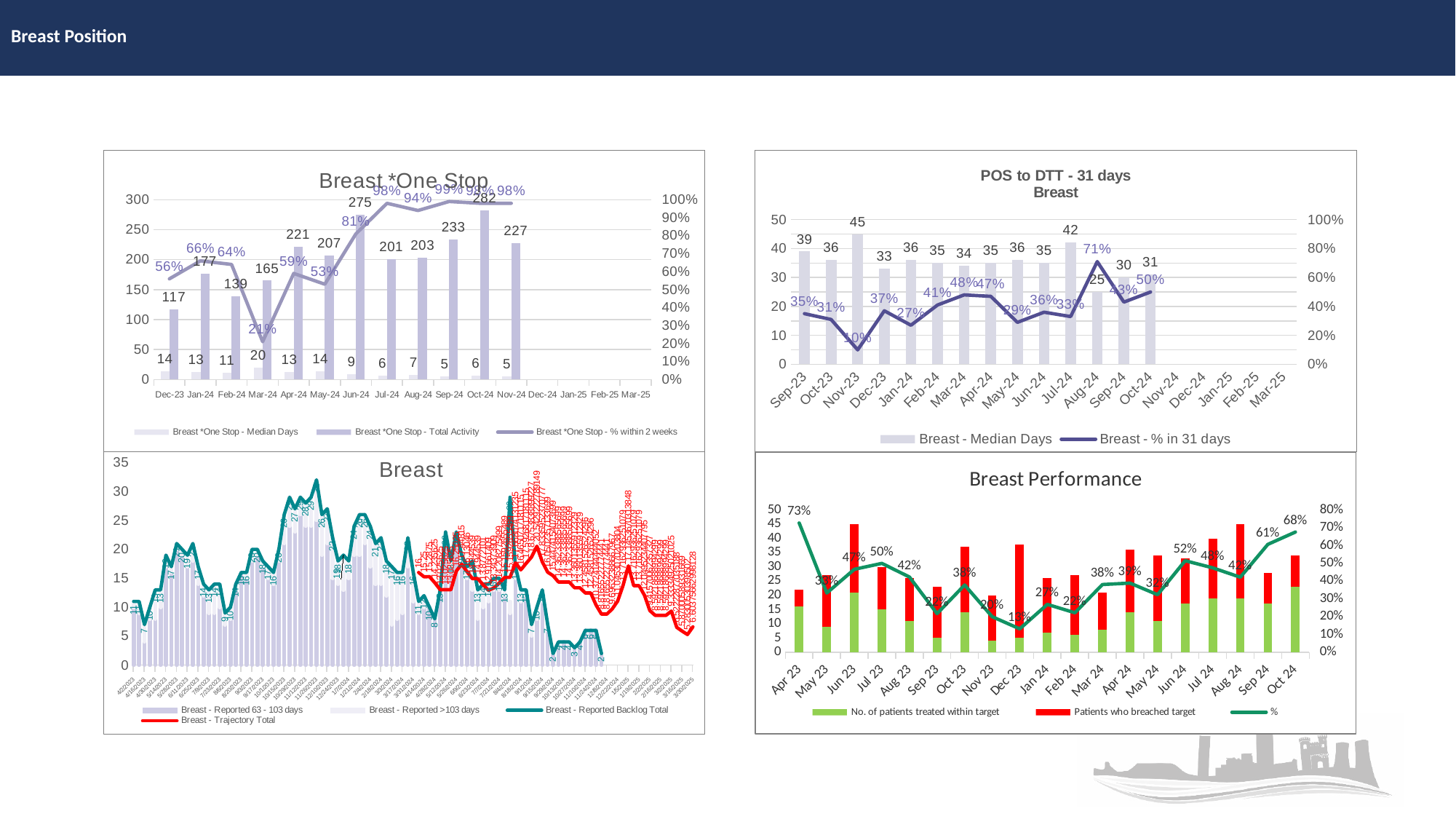
In the 'Breast *One Stop' chart, how many series does the legend list? 3 In the 'Breast *One Stop' chart, which month has the highest Total Activity? Oct-24 In the 'Breast *One Stop' chart, what is the % within 2 weeks for Mar-24? 21% In the 'Breast Performance' chart, what is the % value for Oct 24? 68% In the 'POS to DTT - 31 days Breast' chart, which month has the lowest Median Days? Aug-24 In the 'Breast Performance' chart, which month has the lowest % value? Dec 23 In the 'Breast *One Stop' chart, what is the Total Activity value for Oct-24? 282 In the 'POS to DTT - 31 days Breast' chart, what is the Median Days value for Nov-23? 45 In the 'POS to DTT - 31 days Breast' chart, what is the % in 31 days for Aug-24? 71% In the 'Breast *One Stop' chart, what is the difference in Total Activity between Jun-24 and Jul-24? 74 In the 'POS to DTT - 31 days Breast' chart, which is larger: the Median Days for Sep-23 or for Oct-24? Sep-23 In the 'Breast *One Stop' chart, what is the Median Days value for Mar-24? 20